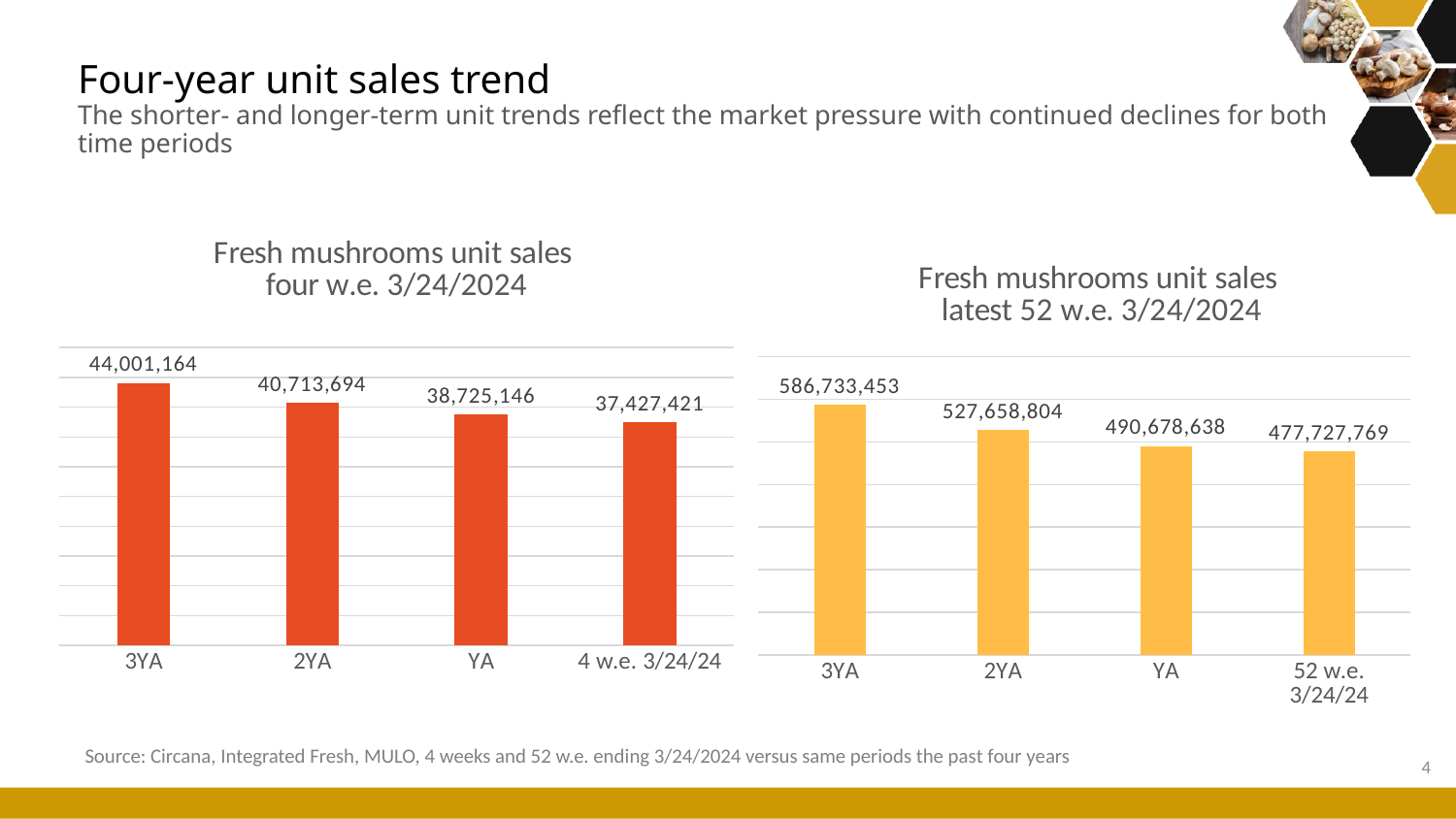
In the 'Fresh mushrooms unit sales latest 52 w.e. 3/24/2024' chart, which is larger, the value for 2YA or the value for YA? 2YA In the 'Fresh mushrooms unit sales latest 52 w.e. 3/24/2024' chart, what is the value for 2YA? 527,658,804 In the 'Fresh mushrooms unit sales latest 52 w.e. 3/24/2024' chart, which category has the lowest value? 52 w.e. 3/24/24 In the 'Fresh mushrooms unit sales four w.e. 3/24/2024' chart, what is the value for 3YA? 44,001,164 In the 'Fresh mushrooms unit sales four w.e. 3/24/2024' chart, what is the value for 4 w.e. 3/24/24? 37,427,421 In the 'Fresh mushrooms unit sales latest 52 w.e. 3/24/2024' chart, what is the value for YA? 490,678,638 How many bars are shown in the 'Fresh mushrooms unit sales four w.e. 3/24/2024' chart? 4 In the 'Fresh mushrooms unit sales four w.e. 3/24/2024' chart, what is the difference between the 3YA value and the 4 w.e. 3/24/24 value? 6,573,743 In the 'Fresh mushrooms unit sales four w.e. 3/24/2024' chart, which category has the highest value? 3YA In the 'Fresh mushrooms unit sales latest 52 w.e. 3/24/2024' chart, what is the difference between the 3YA value and the 52 w.e. 3/24/24 value? 109,005,684 What kind of chart is the 'Fresh mushrooms unit sales latest 52 w.e. 3/24/2024' chart? Bar chart In the 'Fresh mushrooms unit sales four w.e. 3/24/2024' chart, do the values rise or fall from 3YA to 4 w.e. 3/24/24? Fall